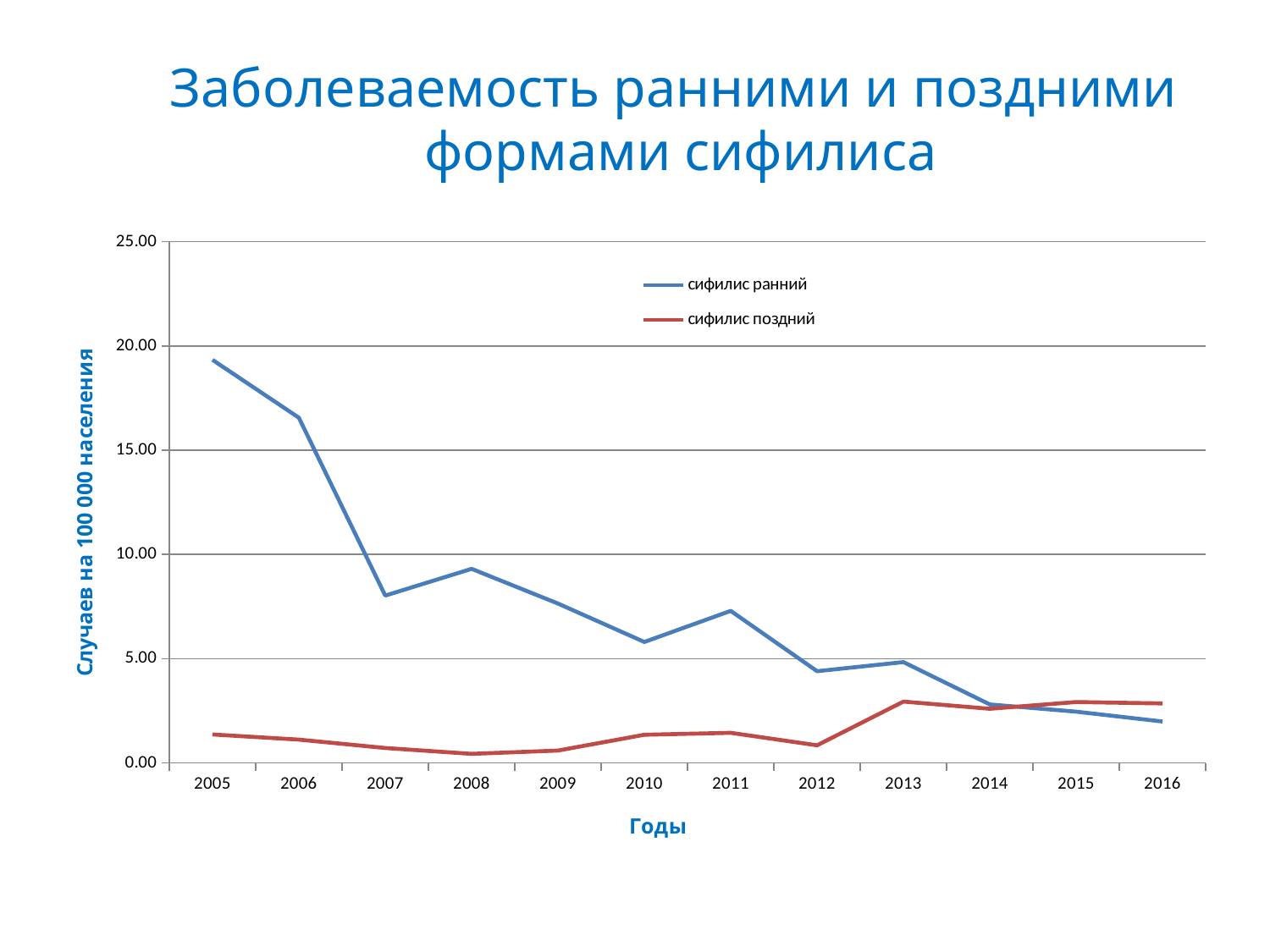
In 2016, which series has the larger value, сифилис ранний or сифилис поздний? сифилис поздний Is the value for сифилис ранний in 2012 greater or less than 5.00? less Is the value for сифилис поздний in 2013 greater or less than 5.00? less Is the value for сифилис ранний in 2007 greater or less than 10.00? less What kind of chart is shown on the slide? line chart Does the сифилис ранний line generally rise or fall from 2005 to 2016? fall How many series does the legend list? 2 How many years are plotted along the x axis? 12 In which year is the value for сифилис ранний lowest? 2016 In which year is the value for сифилис ранний highest? 2005 What is the label of the y axis? Случаев на 100 000 населения